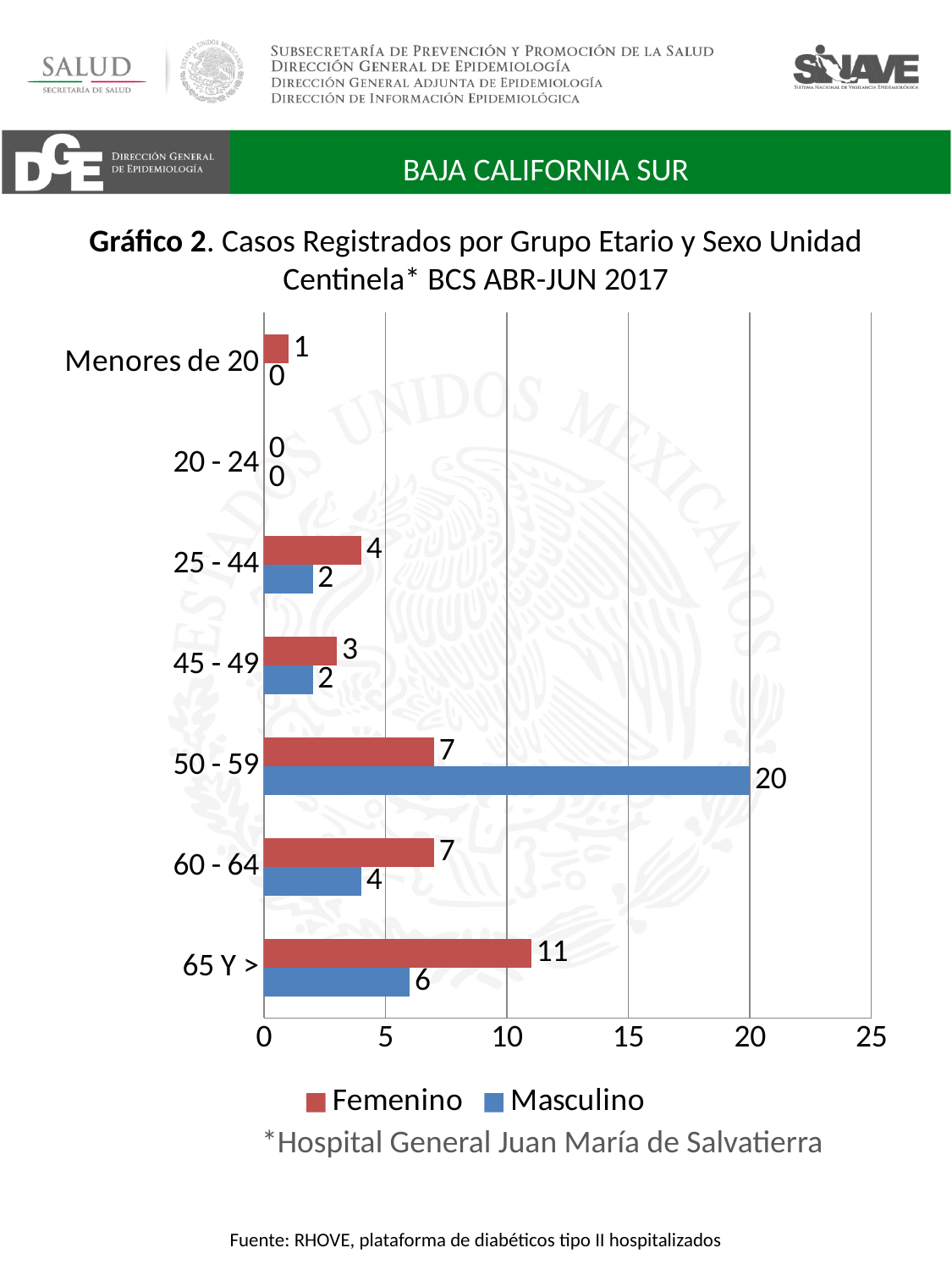
For the 60 - 64 age group, which series has the larger value, Femenino or Masculino? Femenino How many series does the legend list? 2 Which colour represents the Masculino series? Blue What is the difference between the Masculino and Femenino values for the 50 - 59 age group? 13 What is the Femenino value for the 25 - 44 age group? 4 Which age group has the highest Masculino value? 50 - 59 What kind of chart is shown on the slide? Bar chart Is the Masculino value for the 50 - 59 age group greater or less than 15? greater What is the Femenino value for the 65 Y > age group? 11 How many age groups are shown on the chart? 7 Which age group has the highest Femenino value? 65 Y > What is the Masculino value for the 50 - 59 age group? 20